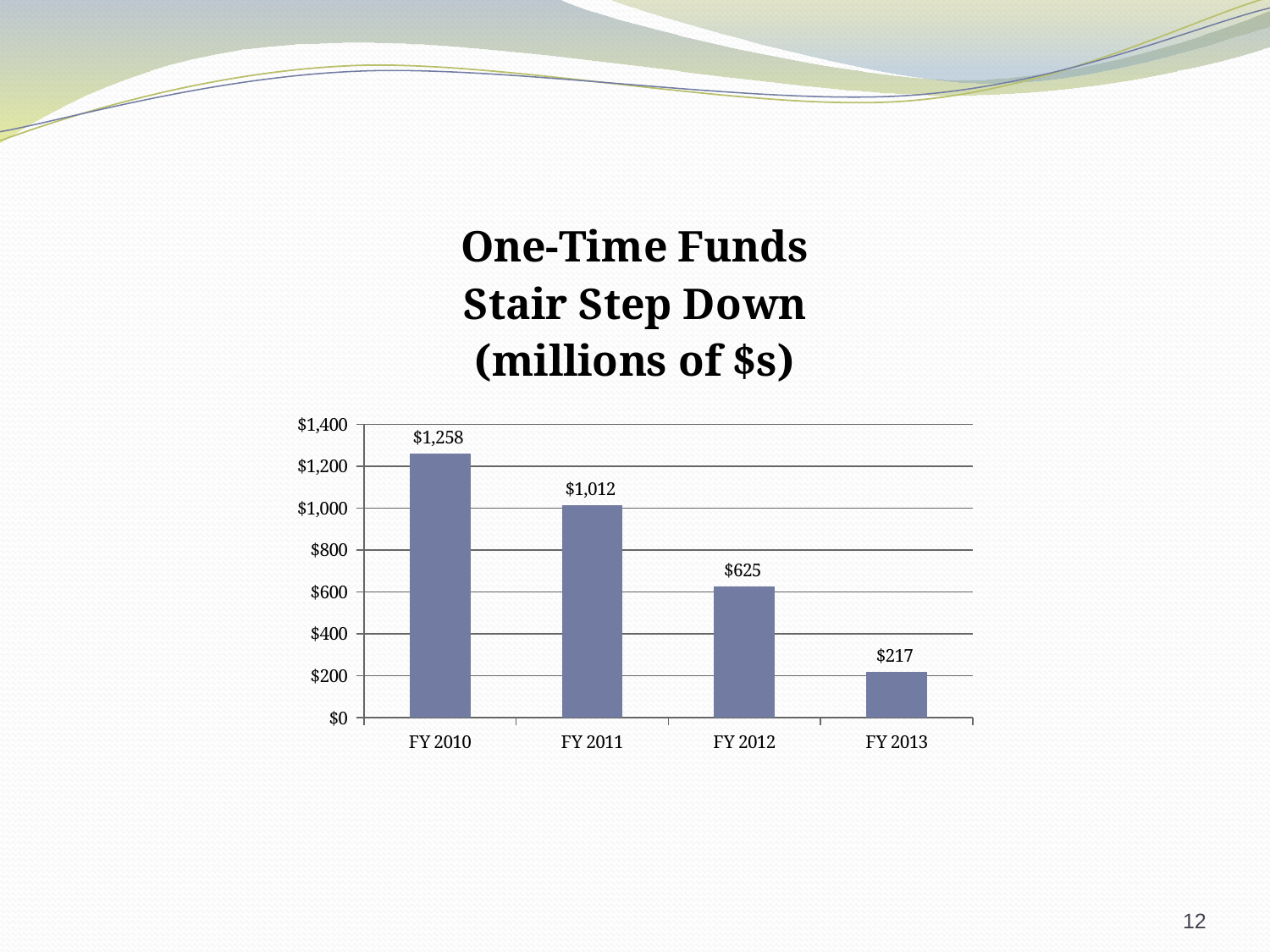
Which is larger, the value for FY 2011 or the value for FY 2012? FY 2011 What is the value for FY 2010? $1,258 What is the difference between the FY 2010 and FY 2011 values? $246 How many fiscal years are shown on the chart? 4 Do the values rise or fall from FY 2010 to FY 2013? fall What is the value for FY 2013? $217 What is the value for FY 2012? $625 What kind of chart is shown on the slide? bar chart Is the value for FY 2012 greater or less than $800? less What is the difference between the FY 2012 and FY 2013 values? $408 Which fiscal year has the lowest value? FY 2013 Which fiscal year has the highest value? FY 2010